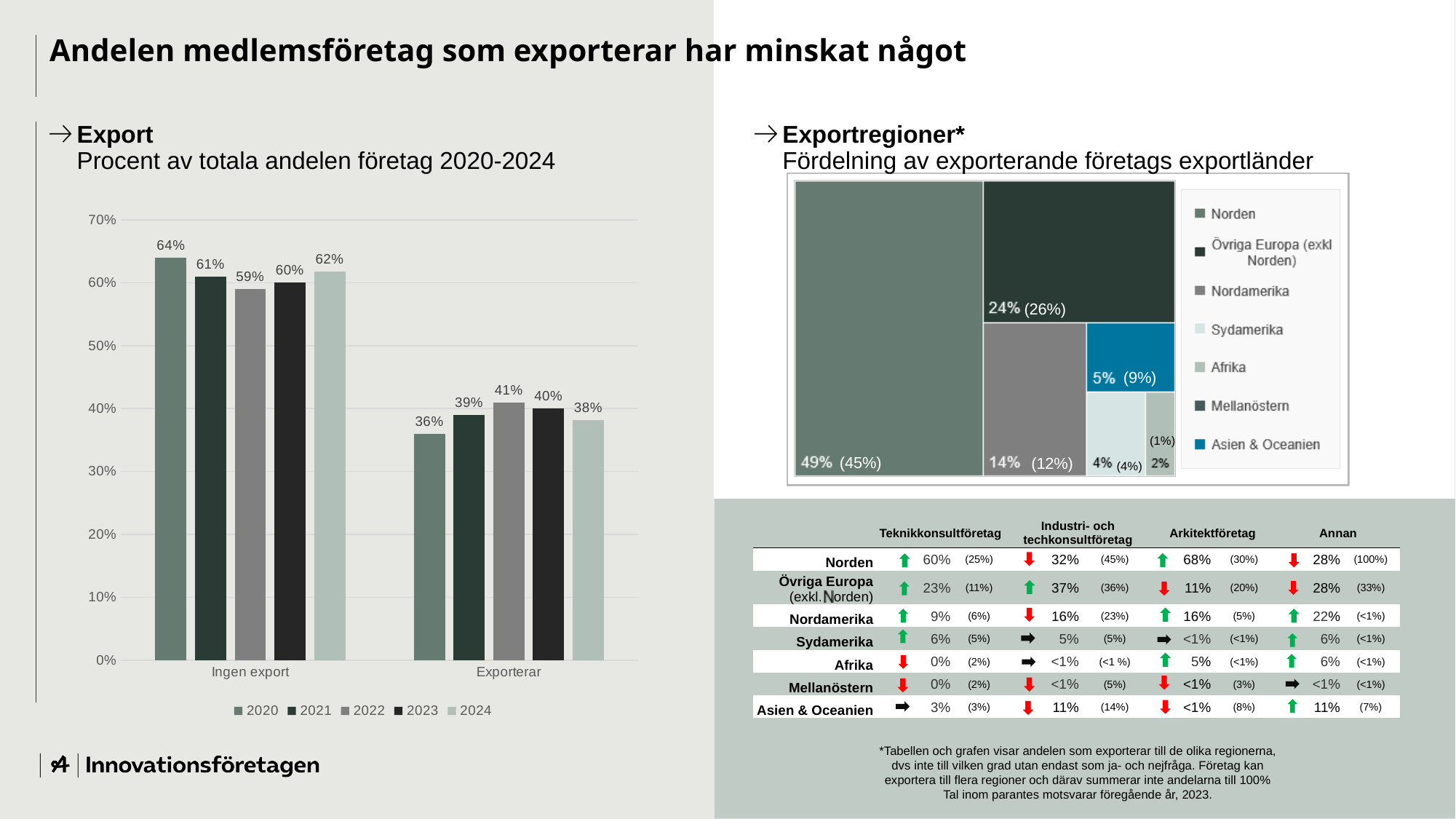
What kind of chart is the 'Export' chart on the left of the slide? Bar chart In the 'Export' bar chart, what is the value for 2022 in the 'Exporterar' category? 41% In the 'Export' bar chart, how many categories are shown on the x axis? 2 How many regions does the legend of the 'Exportregioner*' chart list? 7 In the 'Exportregioner*' chart, what is the value in parentheses shown for Nordamerika? (12%) In the 'Export' bar chart, what is the difference between the 2020 and 2024 values in the 'Exporterar' category? 2% In the 'Export' bar chart, what is the value for 2020 in the 'Ingen export' category? 64% In the 'Exportregioner*' chart, what is the current share shown for Norden? 49% In the 'Export' bar chart, which year has the lowest value in the 'Ingen export' category? 2022 In the 'Export' bar chart, which is larger: the 2021 value for 'Ingen export' or the 2024 value for 'Ingen export'? 2024 In the 'Export' bar chart, which year has the highest value in the 'Exporterar' category? 2022 How many series does the legend of the 'Export' bar chart list? 5